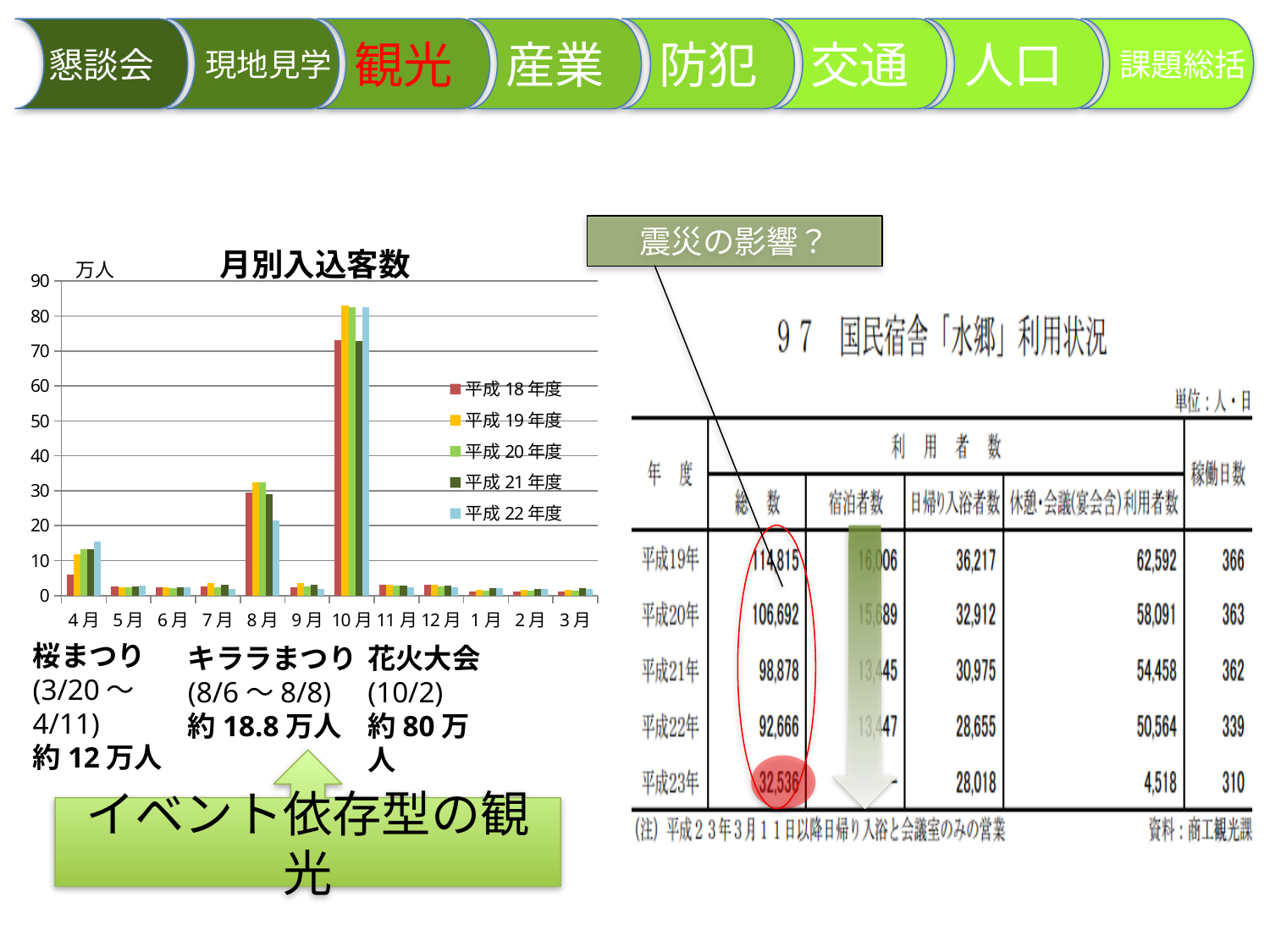
In the 月別入込客数 chart, is the value for 平成20年度 in 8月 greater or less than 20? greater How many months are shown on the x axis of the 月別入込客数 chart? 12 In the 月別入込客数 chart, which is larger for 平成22年度: the value in 4月 or the value in 5月? 4月 What kind of chart is the 月別入込客数 chart? bar chart In the 月別入込客数 chart, is the value for 平成19年度 in 10月 greater or less than 70? greater In the 月別入込客数 chart, which is larger for 平成21年度: the value in 8月 or the value in 10月? 10月 In the 月別入込客数 chart, which month has the highest visitor numbers across all series? 10月 In the 月別入込客数 chart, is the value for 平成22年度 in 8月 greater or less than 30? less What is the title of the bar chart on the slide? 月別入込客数 What unit is shown at the top of the y axis of the 月別入込客数 chart? 万人 How many series does the legend of the 月別入込客数 chart list? 5